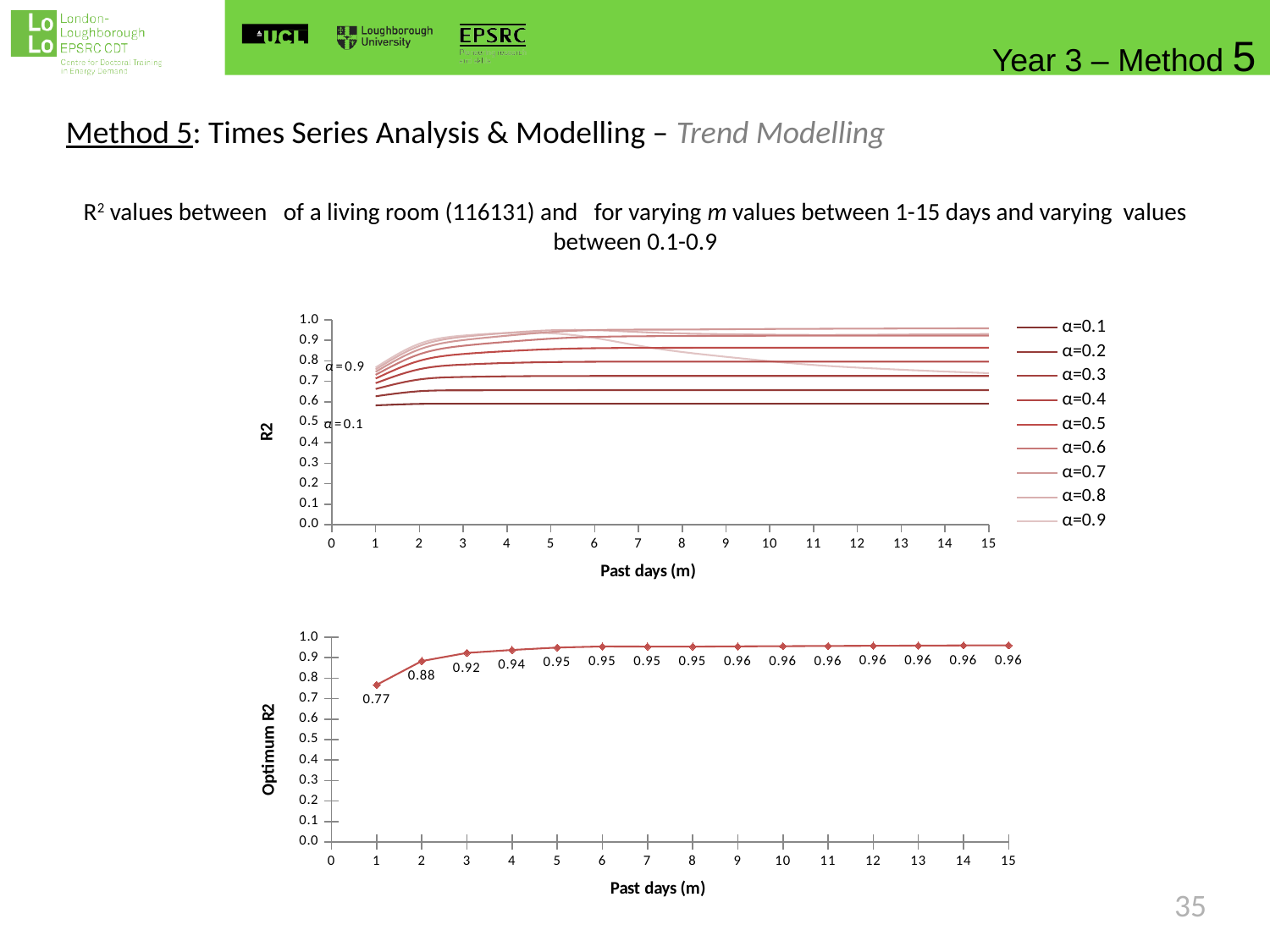
In the top chart (R2 vs Past days), is the value for α=0.1 at 15 past days greater or less than 0.7? less In the bottom chart (Optimum R2), do the values rise or fall as past days increase? rise In the bottom chart (Optimum R2), what is the value at 4 past days? 0.94 In the bottom chart (Optimum R2), what is the value at 15 past days? 0.96 In the bottom chart (Optimum R2), which is larger: the value at 3 past days or at 2 past days? 3 past days In the bottom chart (Optimum R2), how many data points are plotted? 15 In the bottom chart (Optimum R2), what is the difference between the values at 2 past days and 1 past day? 0.11 What kind of chart is the bottom chart (Optimum R2)? line chart In the top chart (R2 vs Past days), how many series does the legend list? 9 In the bottom chart (Optimum R2), at which number of past days is the value lowest? 1 In the bottom chart (Optimum R2), what is the value at 1 past day? 0.77 What is the x-axis title of the top chart? Past days (m)